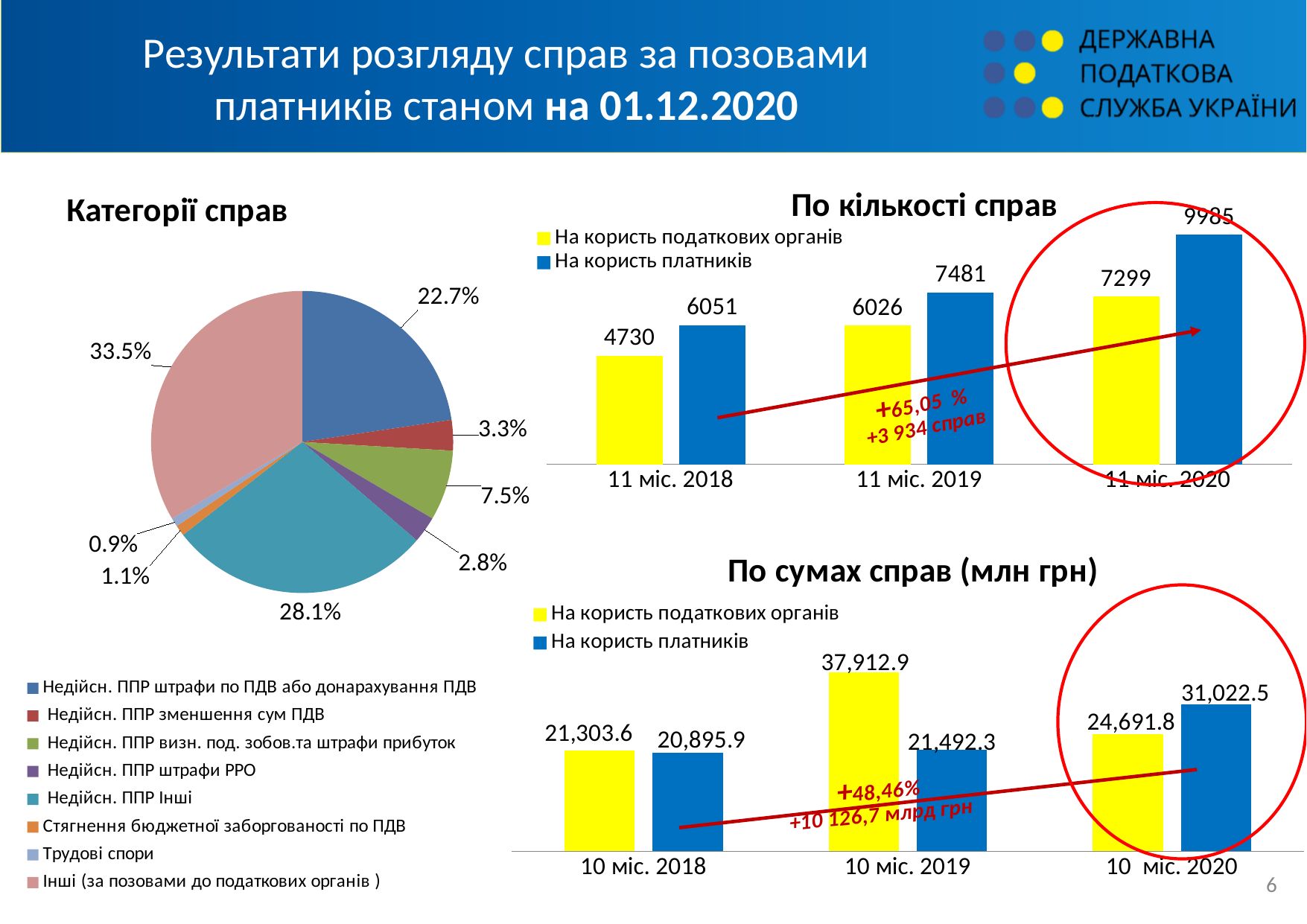
In the 'По сумах справ (млн грн)' chart, which is larger in 10 міс. 2018: 'На користь податкових органів' or 'На користь платників'? На користь податкових органів How many series does the legend of the 'По кількості справ' chart list? 2 In the 'По кількості справ' chart, what is the difference between 'На користь платників' and 'На користь податкових органів' in 11 міс. 2018? 1321 In the 'По кількості справ' chart, do the values for 'На користь податкових органів' rise or fall from 11 міс. 2018 to 11 міс. 2020? rise In the 'По кількості справ' chart, what is the value for 'На користь податкових органів' in 11 міс. 2018? 4730 In the 'По сумах справ (млн грн)' chart, what is the value for 'На користь податкових органів' in 10 міс. 2019? 37,912.9 In the 'Категорії справ' pie chart, what share does 'Недійсн. ППР Інші' have? 28.1% In the 'По сумах справ (млн грн)' chart, which period has the lowest value for 'На користь платників'? 10 міс. 2018 In the 'По сумах справ (млн грн)' chart, what is the value for 'На користь платників' in 10 міс. 2020? 31,022.5 In the 'По кількості справ' chart, what is the value for 'На користь платників' in 11 міс. 2019? 7481 In the 'По кількості справ' chart, which period has the highest value for 'На користь платників'? 11 міс. 2020 In the 'Категорії справ' pie chart, which category has the largest share? Інші (за позовами до податкових органів )